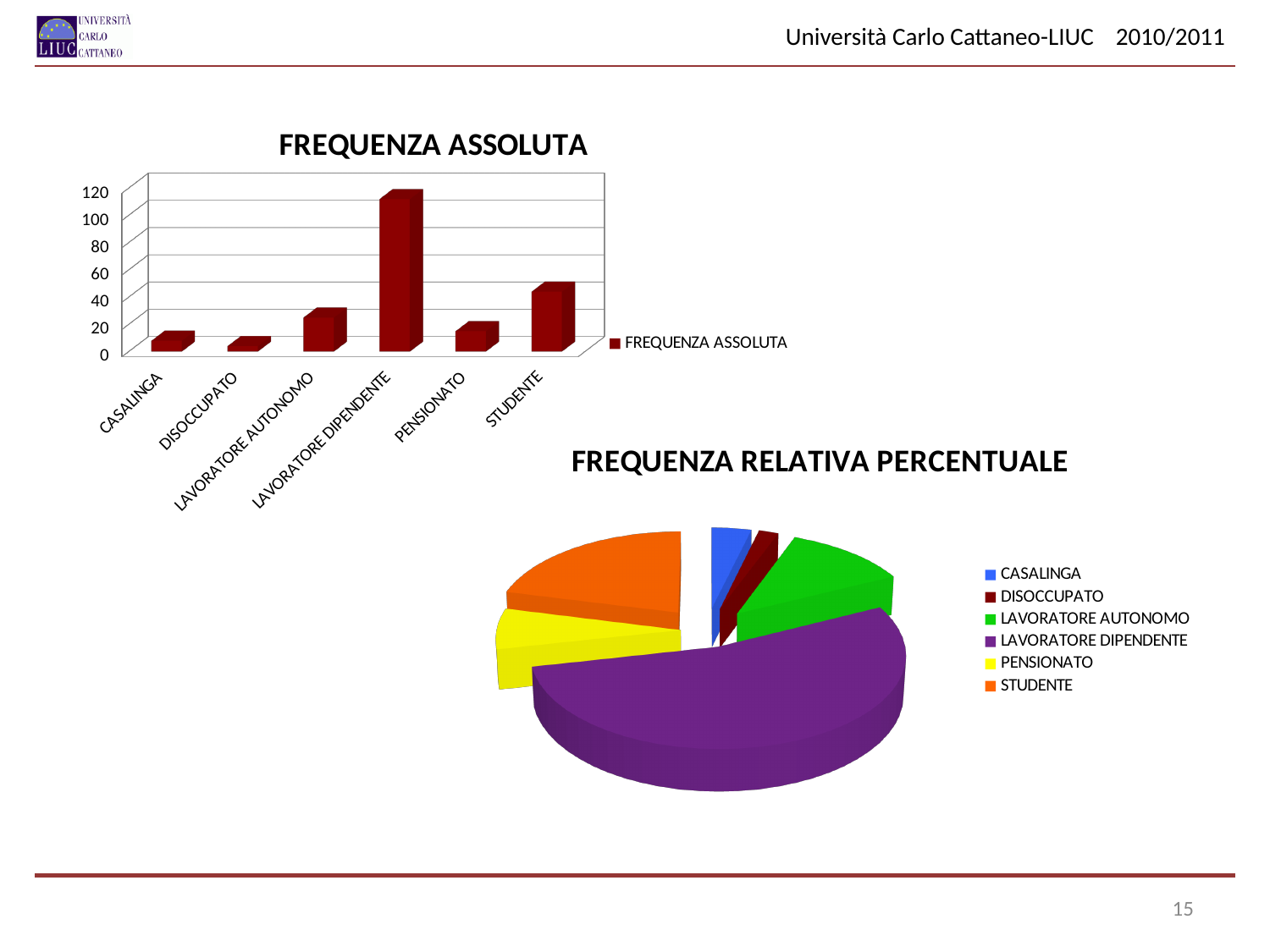
In the "FREQUENZA ASSOLUTA" chart, is the value for LAVORATORE AUTONOMO greater or less than 40? less In the "FREQUENZA ASSOLUTA" chart, which category has the lowest value? DISOCCUPATO In the "FREQUENZA RELATIVA PERCENTUALE" pie chart, which category has the largest slice? LAVORATORE DIPENDENTE In the "FREQUENZA ASSOLUTA" chart, is the value for LAVORATORE DIPENDENTE greater or less than 100? greater In the "FREQUENZA ASSOLUTA" chart, is the value for CASALINGA greater or less than 20? less In the "FREQUENZA ASSOLUTA" chart, which category has the highest value? LAVORATORE DIPENDENTE What type of chart is the "FREQUENZA ASSOLUTA" chart? bar chart In the "FREQUENZA RELATIVA PERCENTUALE" pie chart, what colour is the STUDENTE slice? orange In the "FREQUENZA ASSOLUTA" chart, which is larger, the value for STUDENTE or the value for PENSIONATO? STUDENTE What type of chart is the "FREQUENZA RELATIVA PERCENTUALE" chart? pie chart How many categories are shown in the "FREQUENZA ASSOLUTA" chart? 6